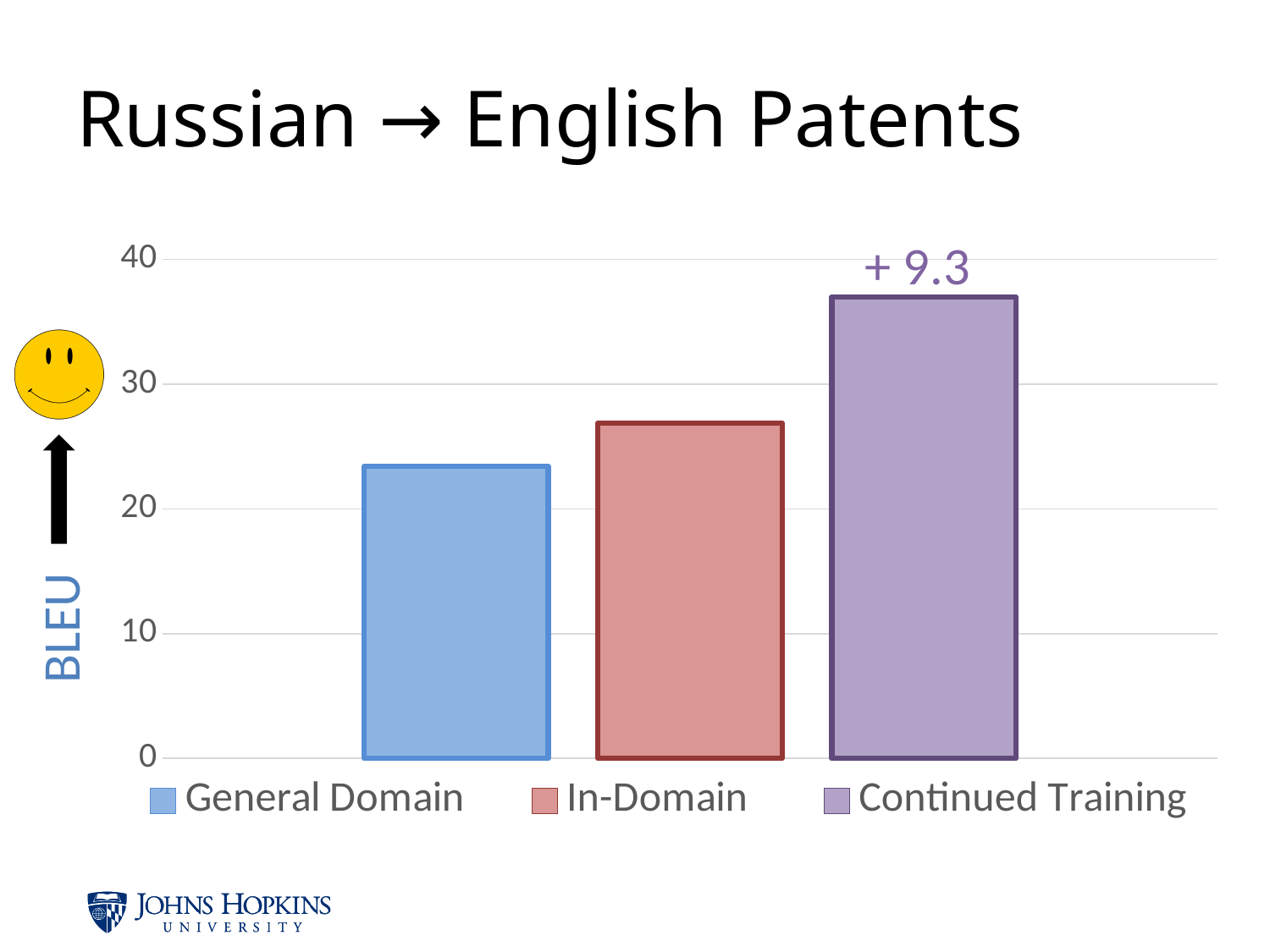
What kind of chart is shown on the slide? bar chart Do the bar values rise or fall from left to right across the chart? rise Is the BLEU score for General Domain greater or less than 30? less How many series does the legend list? 3 Is the BLEU score for In-Domain greater or less than 20? greater What annotation is printed above the Continued Training bar? + 9.3 Which has a higher BLEU score, In-Domain or General Domain? In-Domain Which series has the lowest BLEU score? General Domain How many bars are plotted in the chart? 3 Is the BLEU score for Continued Training greater or less than 30? greater Which series has the highest BLEU score? Continued Training What is the title of the slide containing the chart? Russian → English Patents